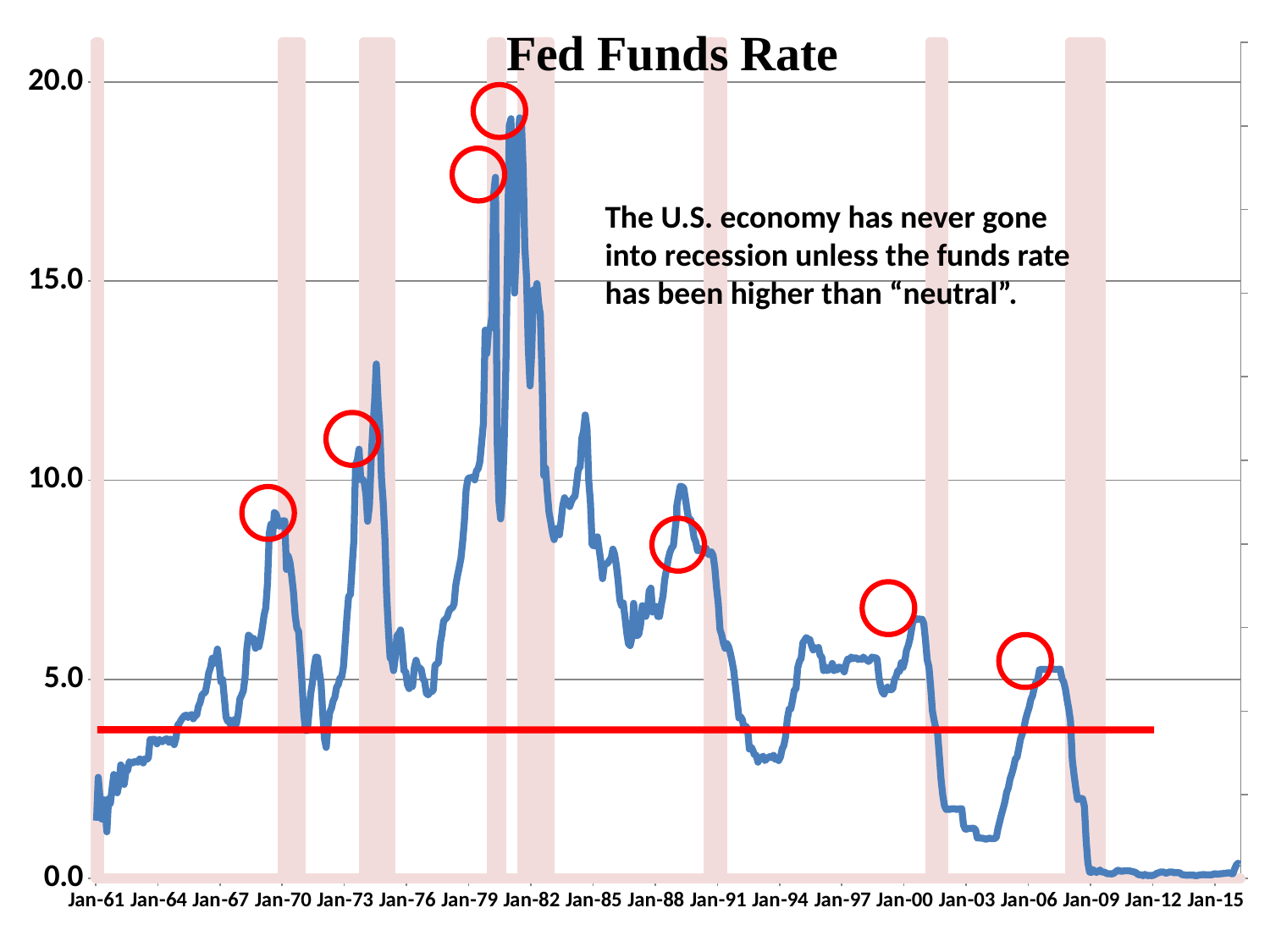
Is the Fed Funds Rate at Jan-85 greater or less than 5.0? greater Is the Fed Funds Rate at Jan-70 greater or less than 5.0? greater Does the Fed Funds Rate generally rise or fall between Jan-82 and Jan-94? fall How many date labels are shown along the x axis? 19 What is the highest value shown on the vertical axis? 20.0 Is the Fed Funds Rate at Jan-12 greater or less than 5.0? less Does the Fed Funds Rate generally rise or fall between Jan-61 and Jan-70? rise What kind of chart is shown on the slide? line chart What is the title of the chart? Fed Funds Rate Between which two x-axis labels does the Fed Funds Rate reach its highest peak? Jan-79 and Jan-82